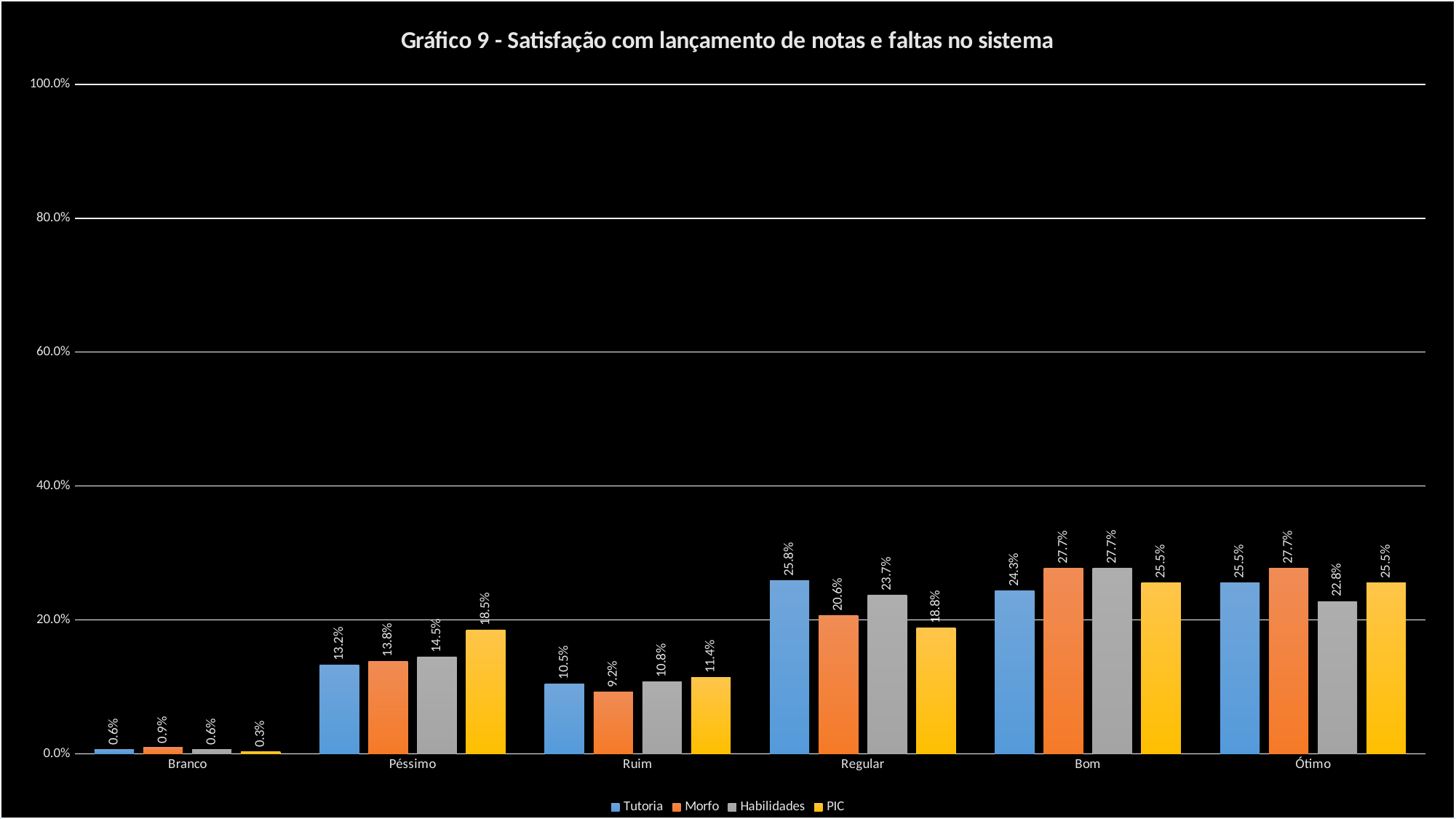
What type of chart is shown on the slide? Bar chart What is the value for Morfo in the Ruim category? 9.2% What is the difference between the Tutoria and Morfo values in the Regular category? 5.2% Which category has the lowest value for PIC? Branco How many categories are shown on the x axis? 6 Which is larger in the Bom category, Tutoria or Morfo? Morfo Which series has the highest value in the Péssimo category? PIC What is the value for Tutoria in the Regular category? 25.8% Is the value for Habilidades in the Regular category greater or less than 20.0%? greater What is the value for PIC in the Péssimo category? 18.5% What is the value for Habilidades in the Ótimo category? 22.8% How many series does the legend list? 4